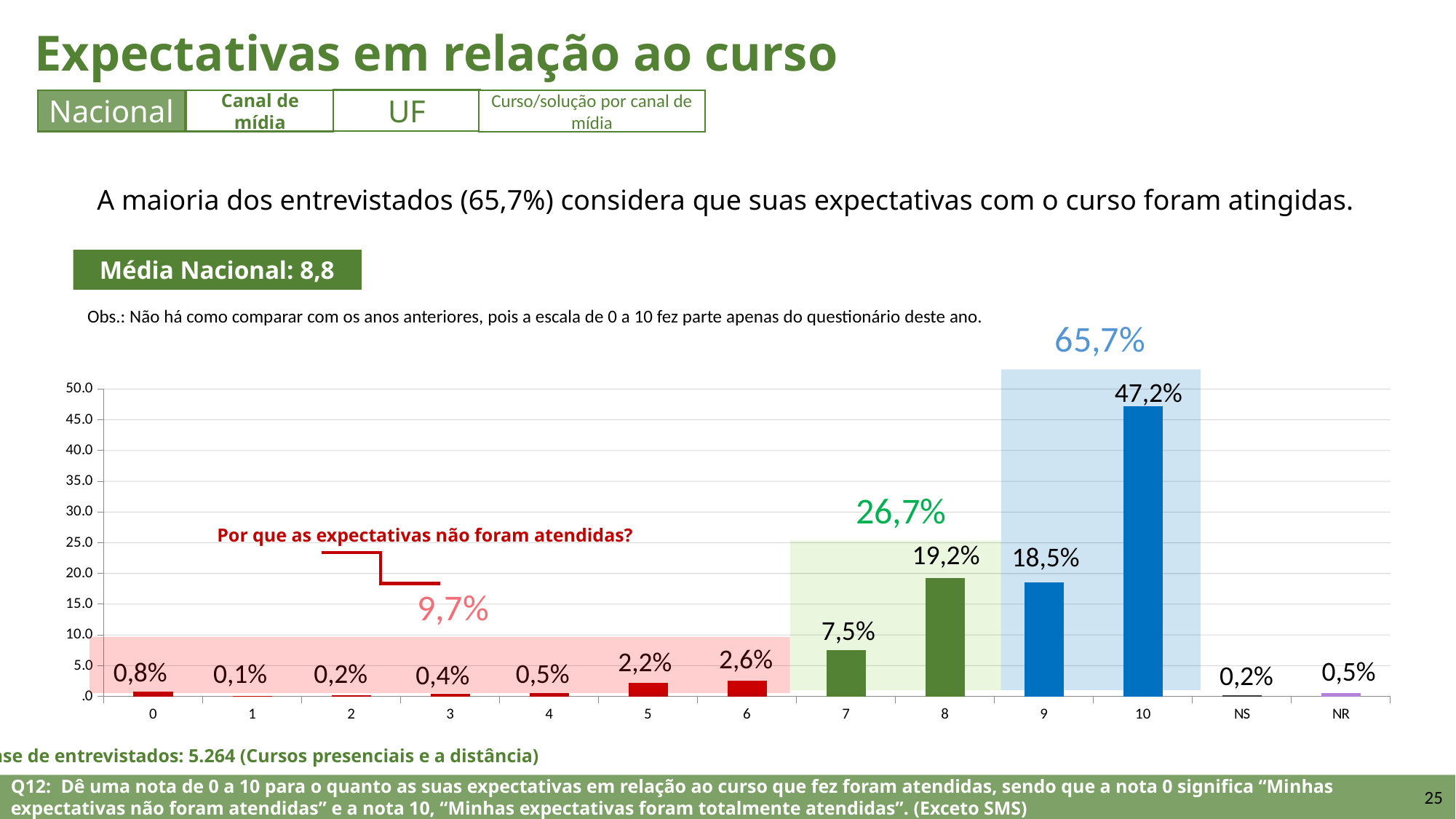
What kind of chart is shown? bar chart What is the difference between the values for categories 10 and 8? 28,0% What combined percentage is shown for the group of categories 9 and 10? 65,7% What is the value for category NR? 0,5% Which category has the highest value? 10 What is the value for category 10? 47,2% Is the value for category 7 greater or less than 10.0? less Which is larger, the value for category 8 or category 9? 8 Which category has the lowest value? 1 What is the value for category 8? 19,2% How many categories are shown on the x axis? 13 What is the Média Nacional shown on the slide? 8,8